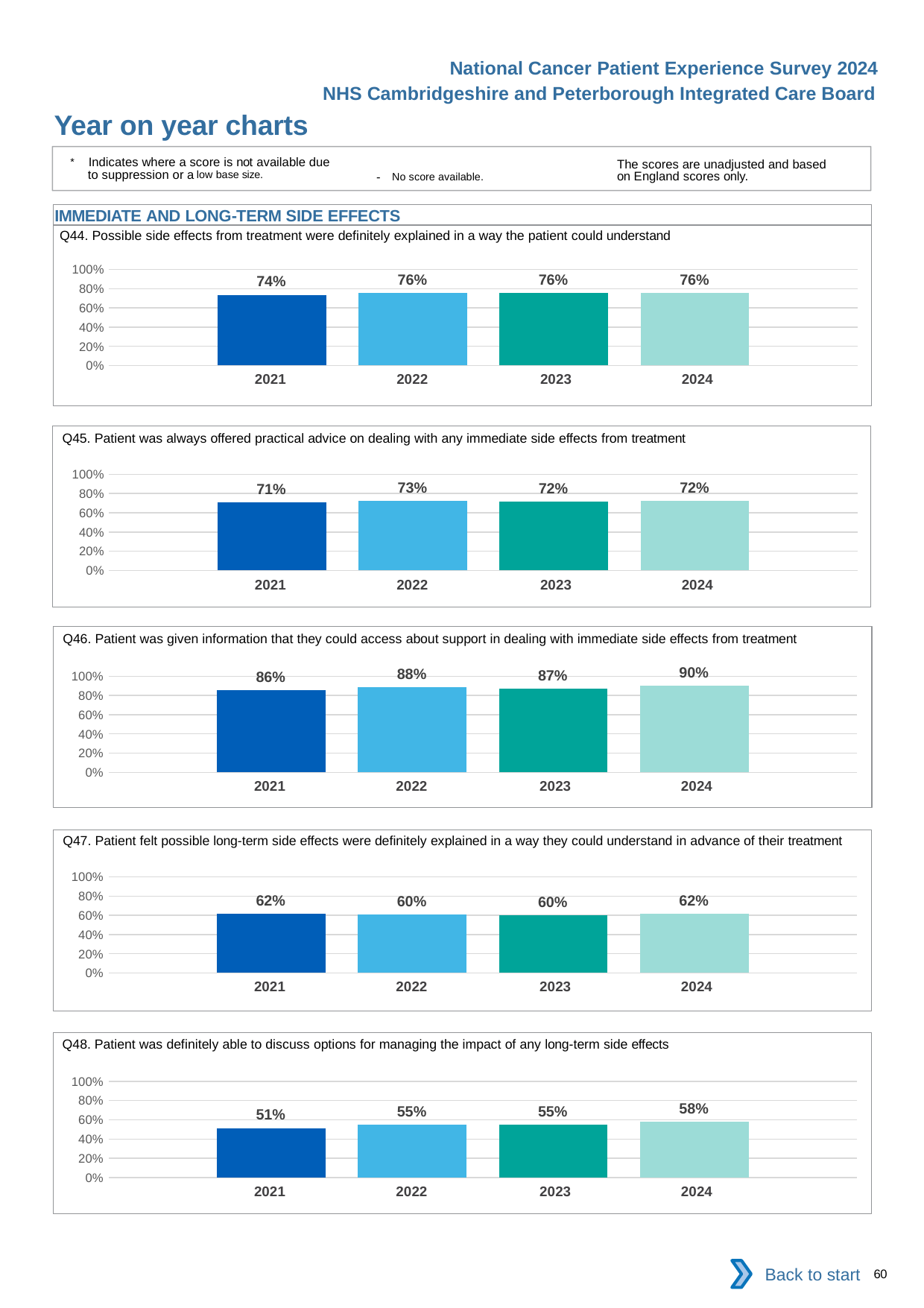
In the Q48 chart, what is the difference between the 2024 and 2021 values? 7 percentage points How many years are shown in the Q44 chart? 4 In the Q46 chart, what is the difference between the 2024 and 2021 values? 4 percentage points In the Q45 chart, which year has the highest value? 2022 In the Q48 chart, which year has the highest value? 2024 In the Q46 chart, which year has the lowest value? 2021 How many charts are shown on the slide? 5 In the Q44 chart, what is the value for 2021? 74% In the Q48 chart, is the value for 2021 larger or smaller than the value for 2022? smaller In the Q47 chart, what is the value for 2023? 60% In the Q48 chart, is the value for 2021 greater or less than 60%? less What kind of chart is the Q45 chart? bar chart